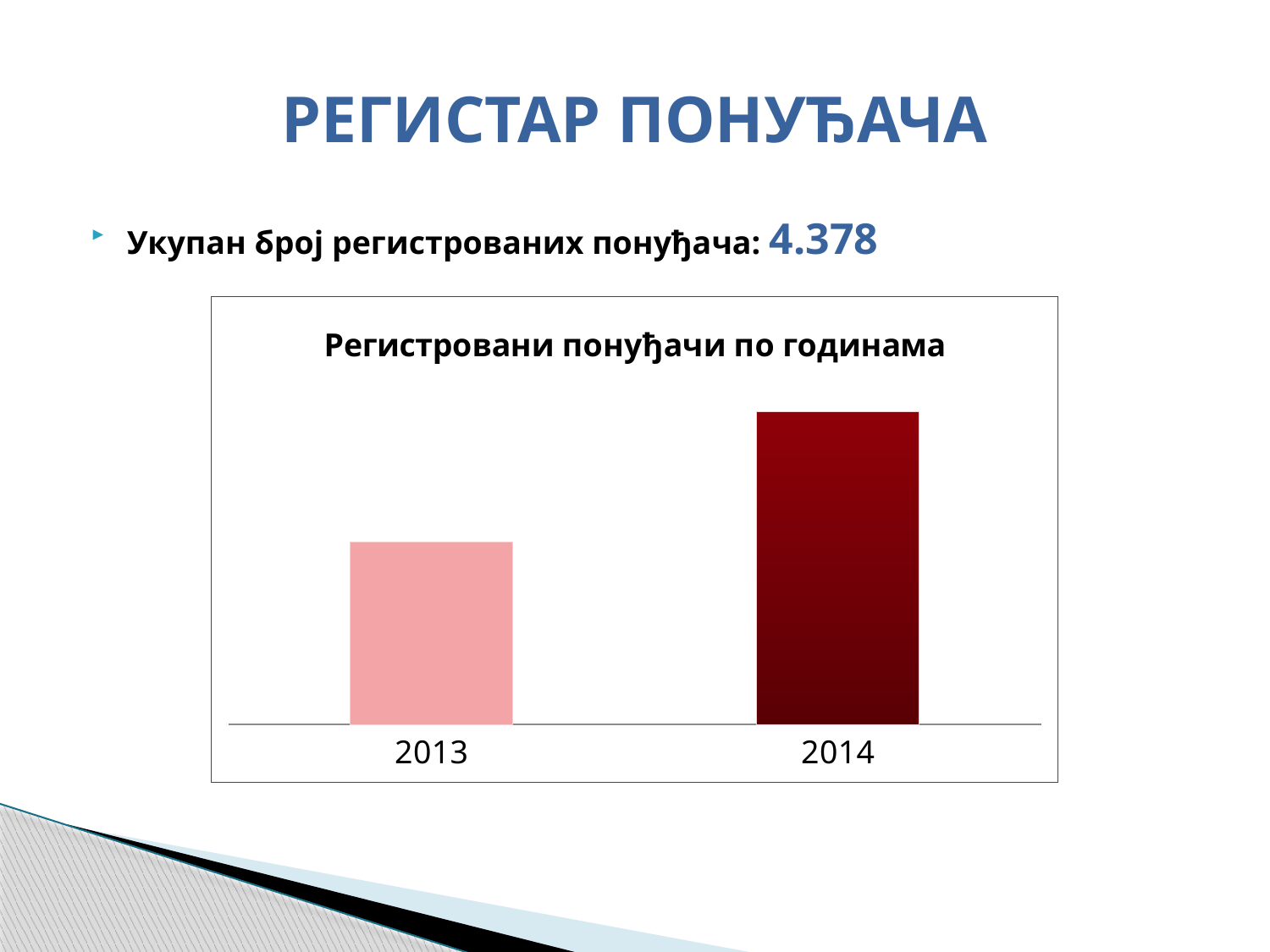
Which year has the lowest bar in the chart? 2013 How many categories (years) are shown on the x axis of the chart? 2 What kind of chart is shown on the slide? bar chart Do the values rise or fall from 2013 to 2014? rise What is the title of the chart? Регистровани понуђачи по годинама Which year has the highest bar in the chart? 2014 Is the bar for 2014 taller or shorter than the bar for 2013? taller What colour is the bar for 2013? light pink